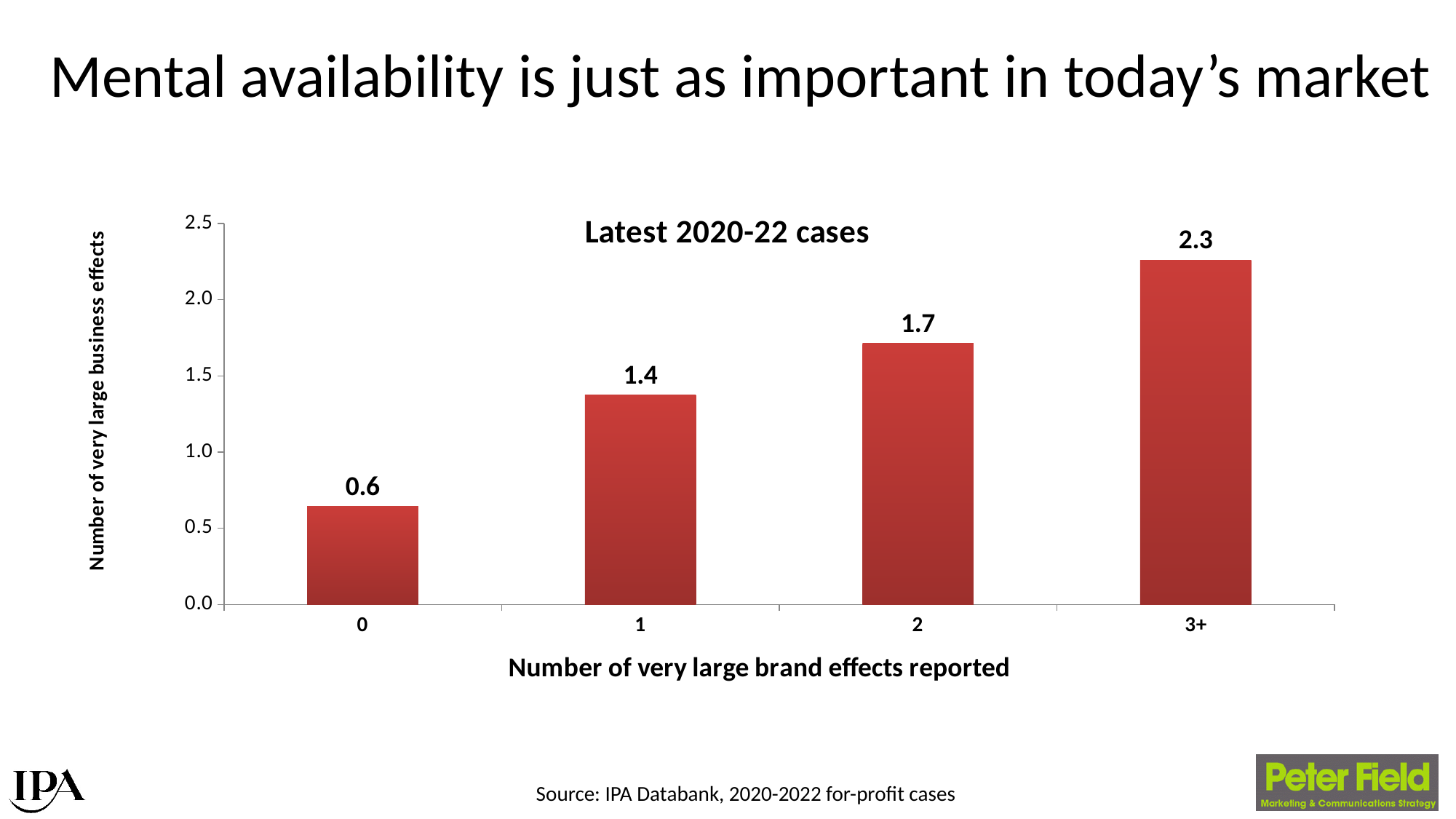
How many categories are shown on the x axis? 4 What is the number of very large business effects for 0 very large brand effects reported? 0.6 What kind of chart is shown on the slide? Bar chart What is the number of very large business effects for 2 very large brand effects reported? 1.7 Which category has the highest number of very large business effects? 3+ Which has more very large business effects: the 1 category or the 2 category? 2 What is the difference in very large business effects between the 3+ and 0 categories? 1.7 Is the value for the 3+ category greater or less than 2.0? greater Do the values rise or fall as the number of very large brand effects reported increases? Rise Which category has the lowest number of very large business effects? 0 What is the number of very large business effects for 3+ very large brand effects reported? 2.3 What is the number of very large business effects for 1 very large brand effect reported? 1.4